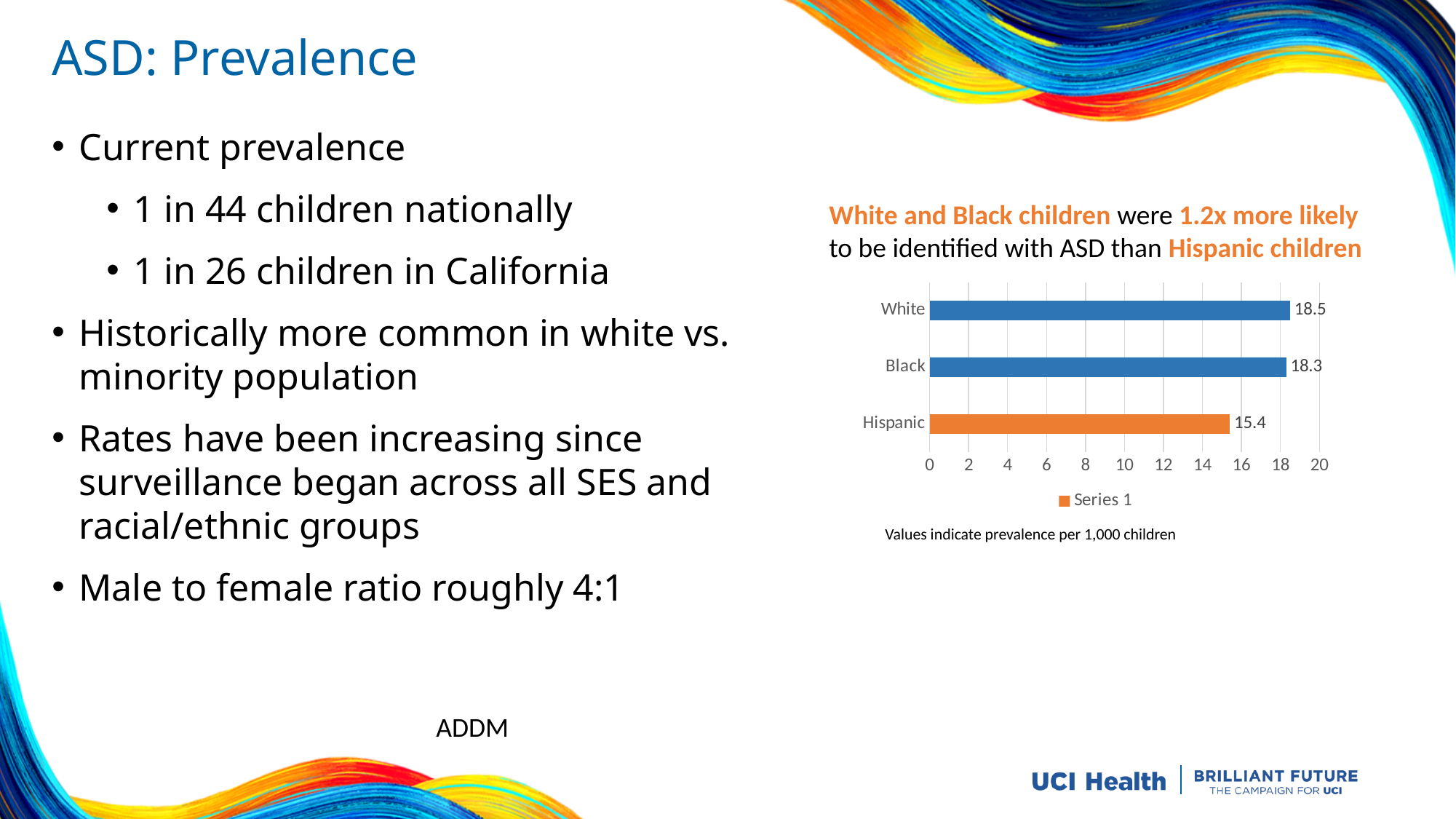
What is the difference between the values for White and Hispanic? 3.1 What is the difference between the values for Black and Hispanic? 2.9 Which category has the lowest value in the chart? Hispanic How many categories are shown in the chart? 3 What is the value for White in the chart? 18.5 What kind of chart is shown on the slide? bar chart Which is larger, the value for Black or the value for Hispanic? Black What is the value for Hispanic in the chart? 15.4 What is the value for Black in the chart? 18.3 How many series does the chart legend list? 1 What is the name of the series shown in the chart legend? Series 1 Is the value for Hispanic greater or less than 16? less